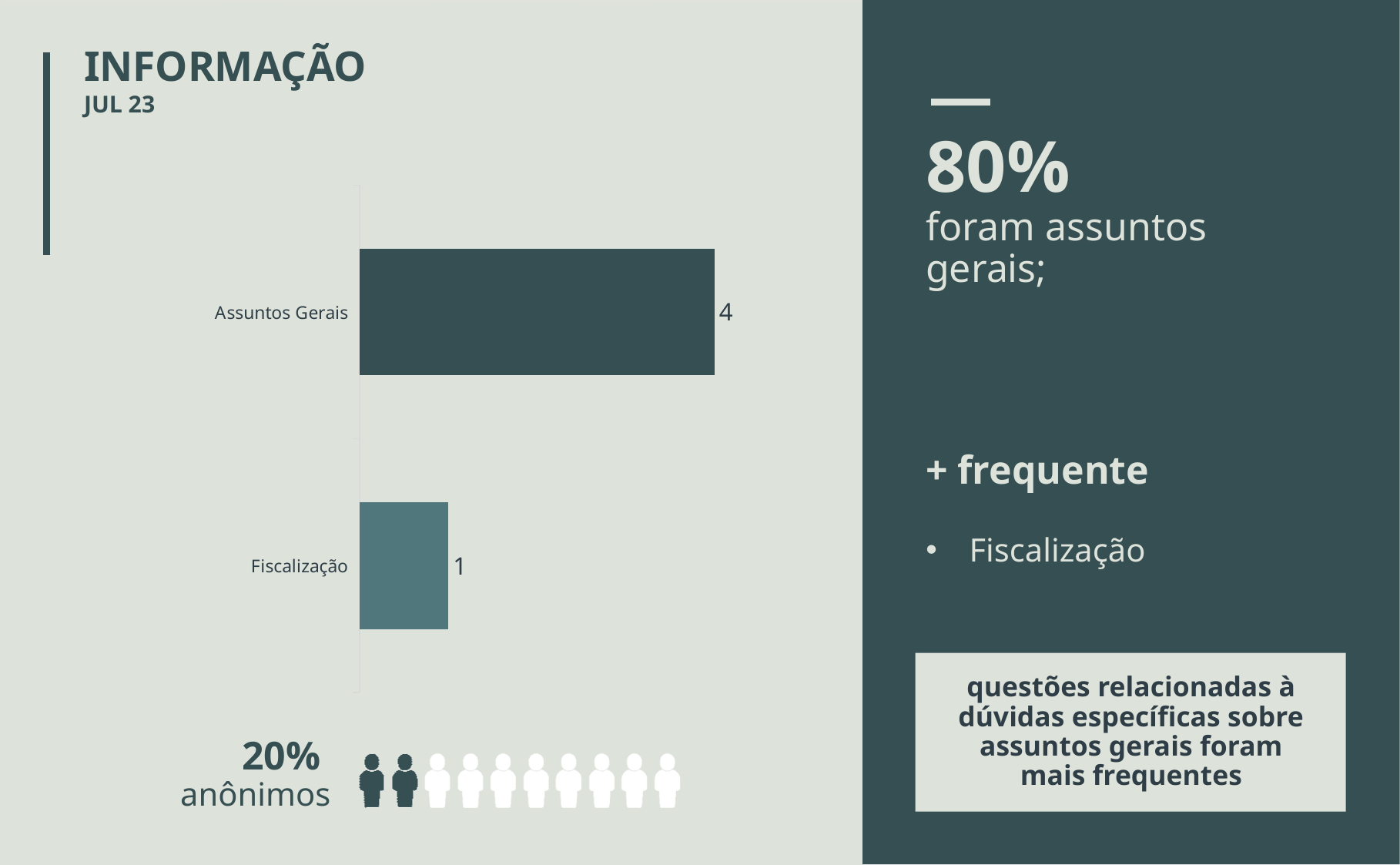
Which category has the lowest value? Fiscalização Which category has the highest value? Assuntos Gerais What is the difference between the values for Assuntos Gerais and Fiscalização? 3 What is the value for Assuntos Gerais? 4 What is the total of the values for Assuntos Gerais and Fiscalização? 5 What is the title of the slide containing the chart? INFORMAÇÃO Which is larger, the value for Assuntos Gerais or the value for Fiscalização? Assuntos Gerais How many categories are shown in the chart? 2 What kind of chart is shown on the slide? Bar chart What is the value for Fiscalização? 1 What period does the slide subtitle indicate for the chart? JUL 23